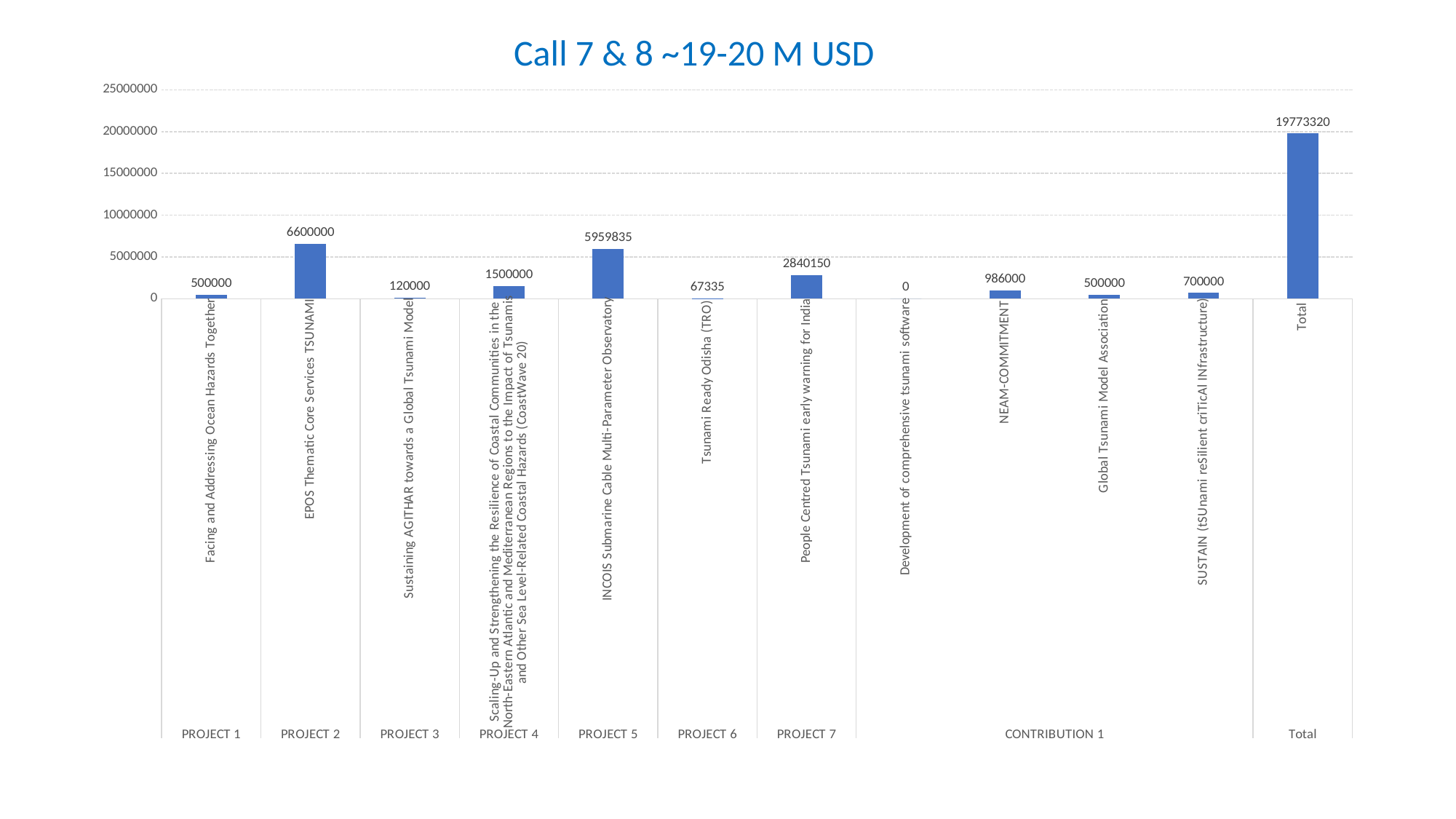
What is the value for EPOS Thematic Core Services TSUNAMI? 6600000 What is the value for Tsunami Ready Odisha (TRO)? 67335 What is the value for NEAM-COMMITMENT? 986000 Is the value for the Total bar greater or less than 15000000? greater Which is larger: the value for People Centred Tsunami early warning for India or the value for SUSTAIN (tSUnami reSilient criTicAl INfrastructure)? People Centred Tsunami early warning for India What is the difference between the values for EPOS Thematic Core Services TSUNAMI and INCOIS Submarine Cable Multi-Parameter Observatory? 640165 How many bars are plotted in the chart, including the Total bar? 12 What type of chart is shown on the slide? bar chart Excluding the Total bar, which category has the highest value? EPOS Thematic Core Services TSUNAMI What is the value shown for the Total bar? 19773320 What is the value for INCOIS Submarine Cable Multi-Parameter Observatory? 5959835 Which category has the lowest value? Development of comprehensive tsunami software